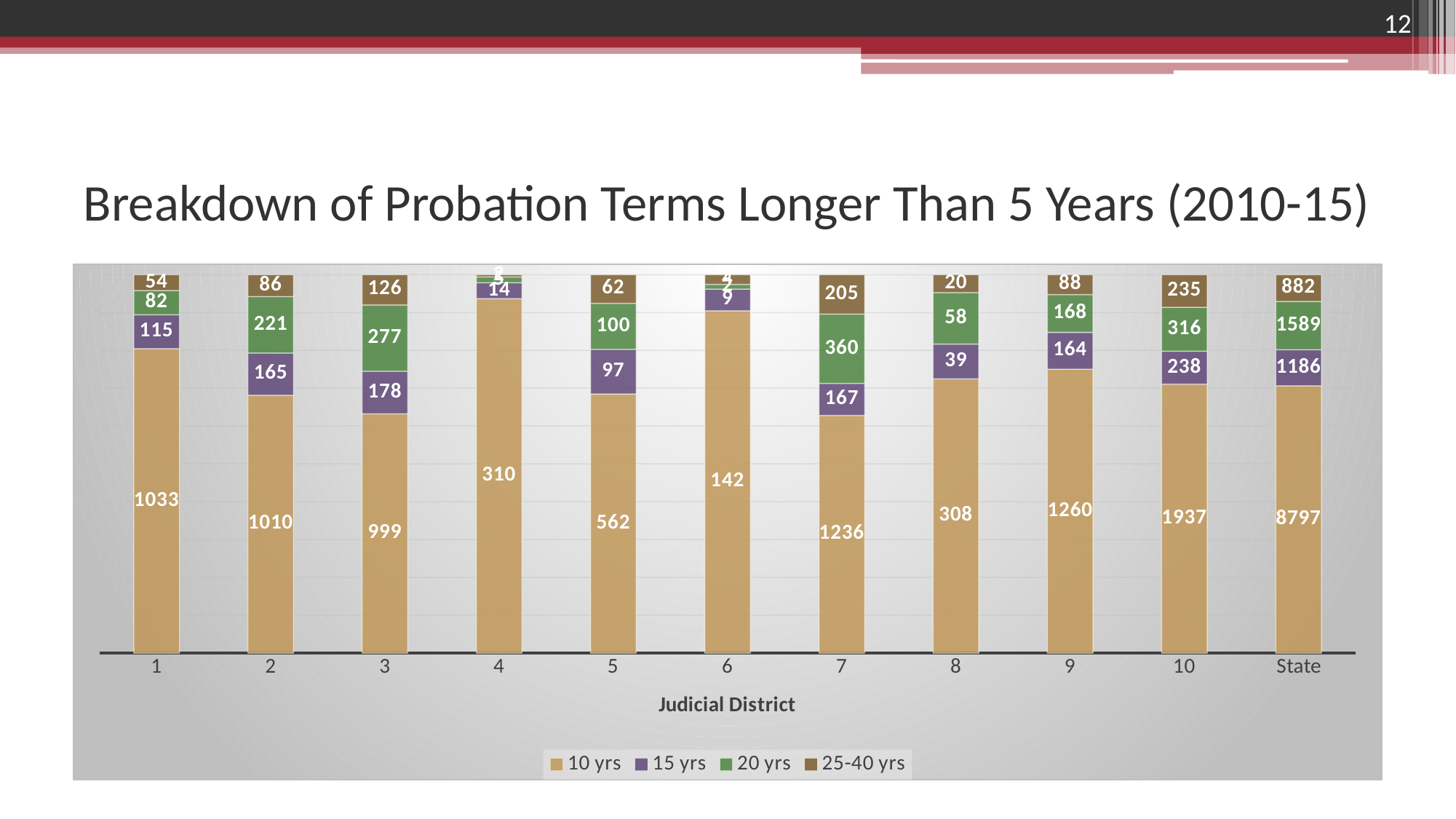
How many categories are shown on the x axis? 11 What is the value for the 15 yrs series in Judicial District 9? 164 What is the value for the 10 yrs series in Judicial District 7? 1236 Among Judicial Districts 1 through 10, which district has the highest 10 yrs value? 10 What is the total of all four series for Judicial District 8? 425 How many series does the legend list? 4 What kind of chart is shown on the slide? Stacked bar chart Which is larger, the 15 yrs value for Judicial District 2 or for Judicial District 3? Judicial District 3 What is the value for the 20 yrs series in Judicial District 2? 221 Among Judicial Districts 1 through 10, which district has the lowest 10 yrs value? 6 What is the difference between the 20 yrs values for Judicial District 7 and Judicial District 3? 83 What is the value for the 25-40 yrs series for State? 882